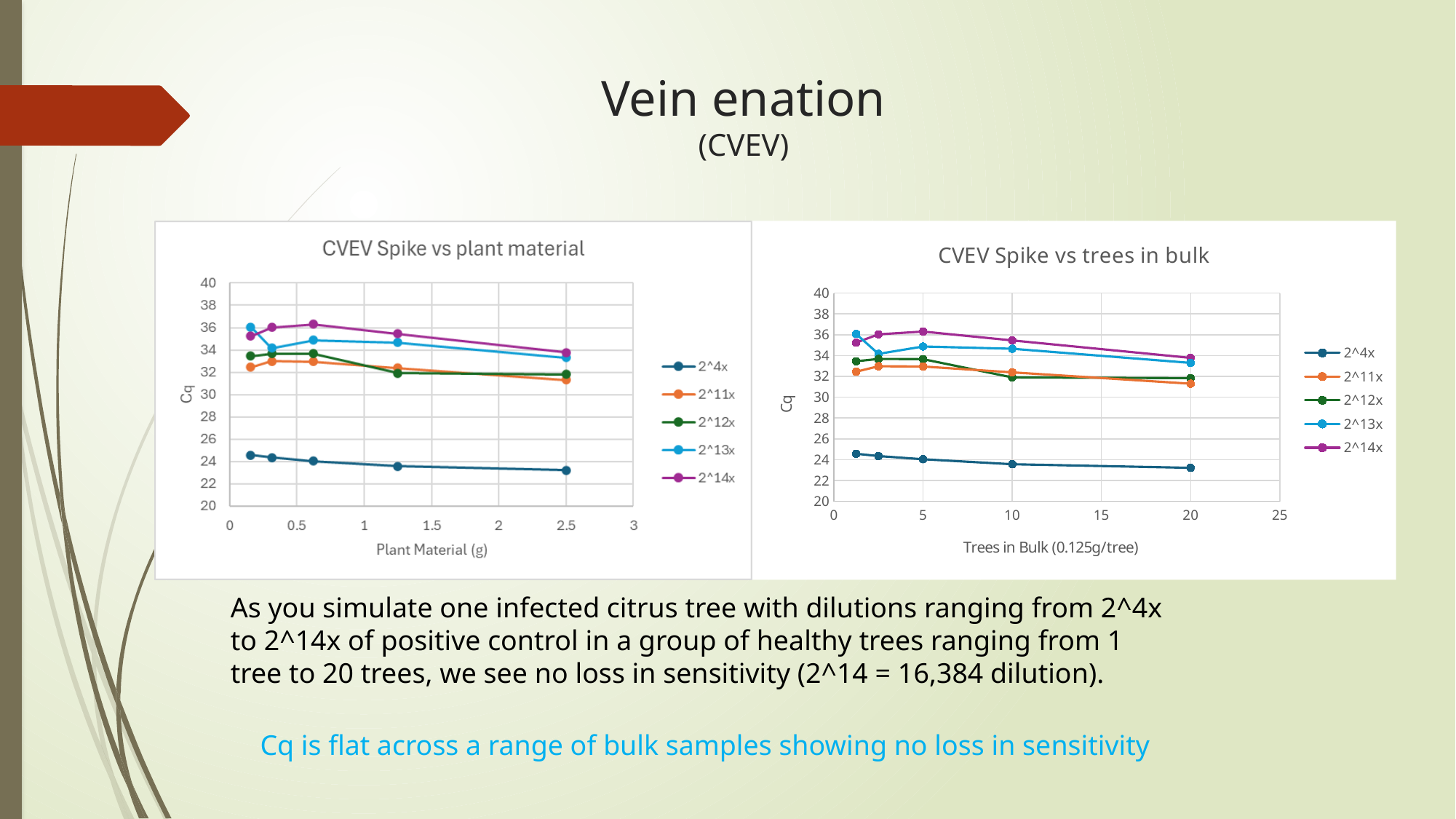
In the 'CVEV Spike vs trees in bulk' chart, which series has the highest Cq values? 2^14x In the 'CVEV Spike vs plant material' chart, is the Cq value for 2^4x at 2.5 g greater or less than 24? less How many series does the legend of the 'CVEV Spike vs trees in bulk' chart list? 5 What type of chart is the 'CVEV Spike vs plant material' chart? line chart In the 'CVEV Spike vs plant material' chart, which series has the lowest Cq values? 2^4x In the 'CVEV Spike vs trees in bulk' chart, is the Cq value for 2^14x at 20 trees greater or less than 32? greater In the 'CVEV Spike vs trees in bulk' chart, which series has the larger Cq at 5 trees: 2^14x or 2^11x? 2^14x In the 'CVEV Spike vs plant material' chart, is the Cq value for 2^13x at 2.5 g greater or less than 30? greater What is the x-axis label of the 'CVEV Spike vs trees in bulk' chart? Trees in Bulk (0.125g/tree) In the 'CVEV Spike vs plant material' chart, does the Cq for the 2^4x series rise or fall as plant material increases? fall What is the y-axis label of the 'CVEV Spike vs plant material' chart? Cq In the 'CVEV Spike vs plant material' chart, how many data points does the 2^4x series have? 5